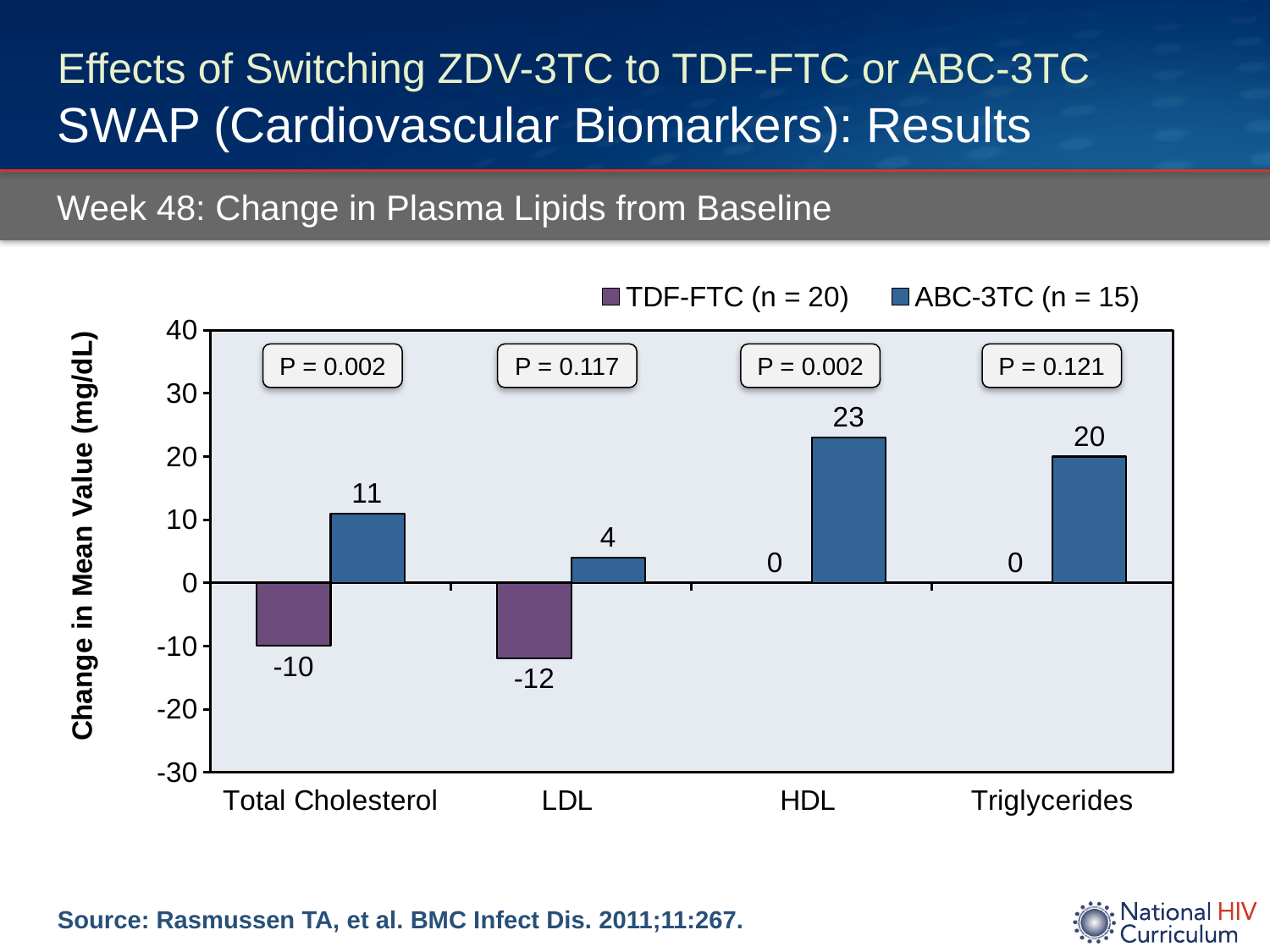
What is the difference between the ABC-3TC and TDF-FTC values for Total Cholesterol? 21 How many lipid categories are shown on the x axis? 4 Which category has the highest value for ABC-3TC? HDL What P value is shown above the HDL category? P = 0.002 Which is larger, the ABC-3TC value for LDL or the ABC-3TC value for Triglycerides? Triglycerides What is the change in mean value for TDF-FTC in Total Cholesterol? -10 What kind of chart is shown on the slide? Bar chart How many series does the legend list? 2 What is the change in mean value for TDF-FTC in LDL? -12 What is the change in mean value for ABC-3TC in HDL? 23 What is the change in mean value for ABC-3TC in Triglycerides? 20 Which category has the lowest value for TDF-FTC? LDL